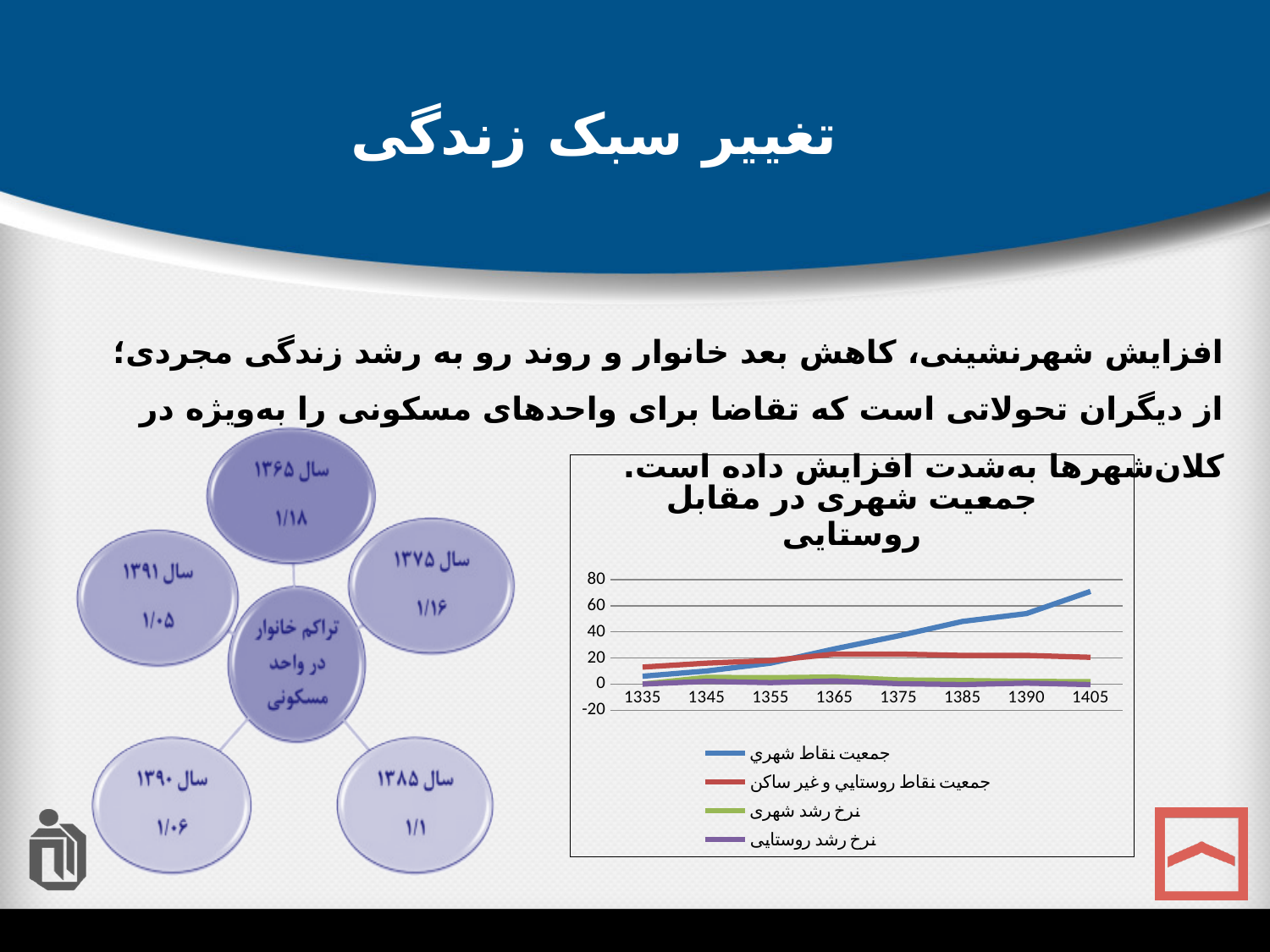
In the chart "جمعیت شهری در مقابل روستایی", is the value of "جمعیت نقاط روستايي و غير ساكن" at 1405 greater or less than 40? less In the chart "جمعیت شهری در مقابل روستایی", does the series "جمعیت نقاط شهري" rise or fall from 1335 to 1405? rise What is the first year shown on the x axis of the chart "جمعیت شهری در مقابل روستایی"? 1335 In the chart "جمعیت شهری در مقابل روستایی", is the value of "جمعیت نقاط شهري" at 1405 greater or less than 60? greater How many years are labelled along the x axis of the chart "جمعیت شهری در مقابل روستایی"? 8 What kind of chart is the chart titled "جمعیت شهری در مقابل روستایی"? line chart In the chart "جمعیت شهری در مقابل روستایی", is the value of "جمعیت نقاط شهري" at 1335 greater or less than 20? less How many series does the legend of the chart "جمعیت شهری در مقابل روستایی" list? 4 What colour is the line for "جمعیت نقاط شهري" in the chart "جمعیت شهری در مقابل روستایی"? blue In the chart "جمعیت شهری در مقابل روستایی", which series has the highest value at 1405? جمعیت نقاط شهري In the chart "جمعیت شهری در مقابل روستایی", which is larger at 1335: "جمعیت نقاط شهري" or "جمعیت نقاط روستايي و غير ساكن"? جمعیت نقاط روستايي و غير ساكن In the chart "جمعیت شهری در مقابل روستایی", which is larger at 1405: "جمعیت نقاط شهري" or "جمعیت نقاط روستايي و غير ساكن"? جمعیت نقاط شهري